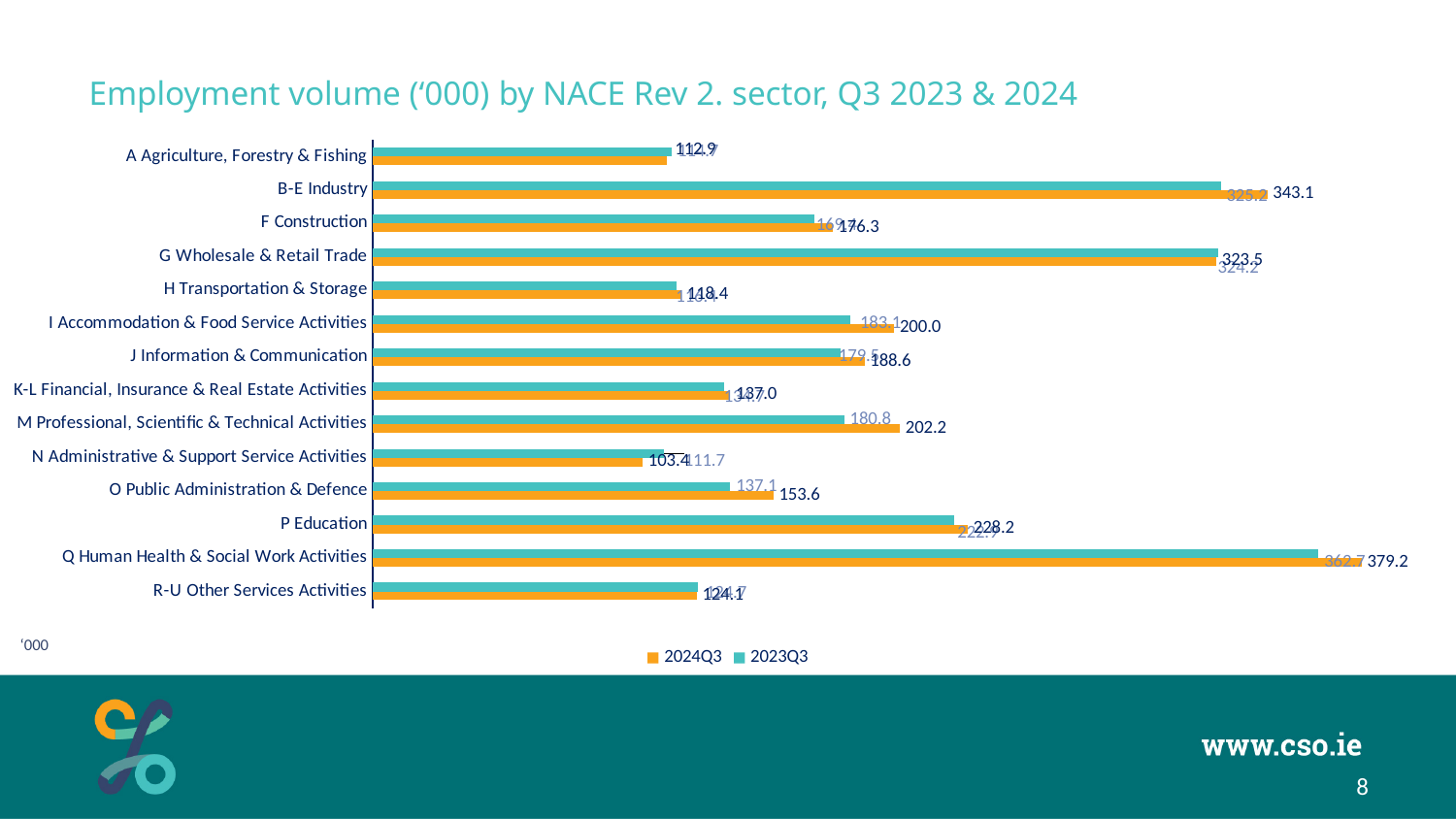
How many NACE sectors are plotted on the chart? 14 What is the difference between the 2024Q3 and 2023Q3 values for O Public Administration & Defence? 16.5 Which sector has the lowest 2024Q3 employment volume? N Administrative & Support Service Activities What is the 2023Q3 employment volume for O Public Administration & Defence? 137.1 What kind of chart is shown on the slide? bar chart How many series does the legend list? 2 What is the 2024Q3 employment volume for I Accommodation & Food Service Activities? 200.0 What is the 2024Q3 employment volume for Q Human Health & Social Work Activities? 379.2 What are the two series named in the legend? 2024Q3 and 2023Q3 What is the 2023Q3 employment volume for M Professional, Scientific & Technical Activities? 180.8 Which sector has the highest 2024Q3 employment volume? Q Human Health & Social Work Activities For N Administrative & Support Service Activities, which is larger: the 2023Q3 value or the 2024Q3 value? 2023Q3